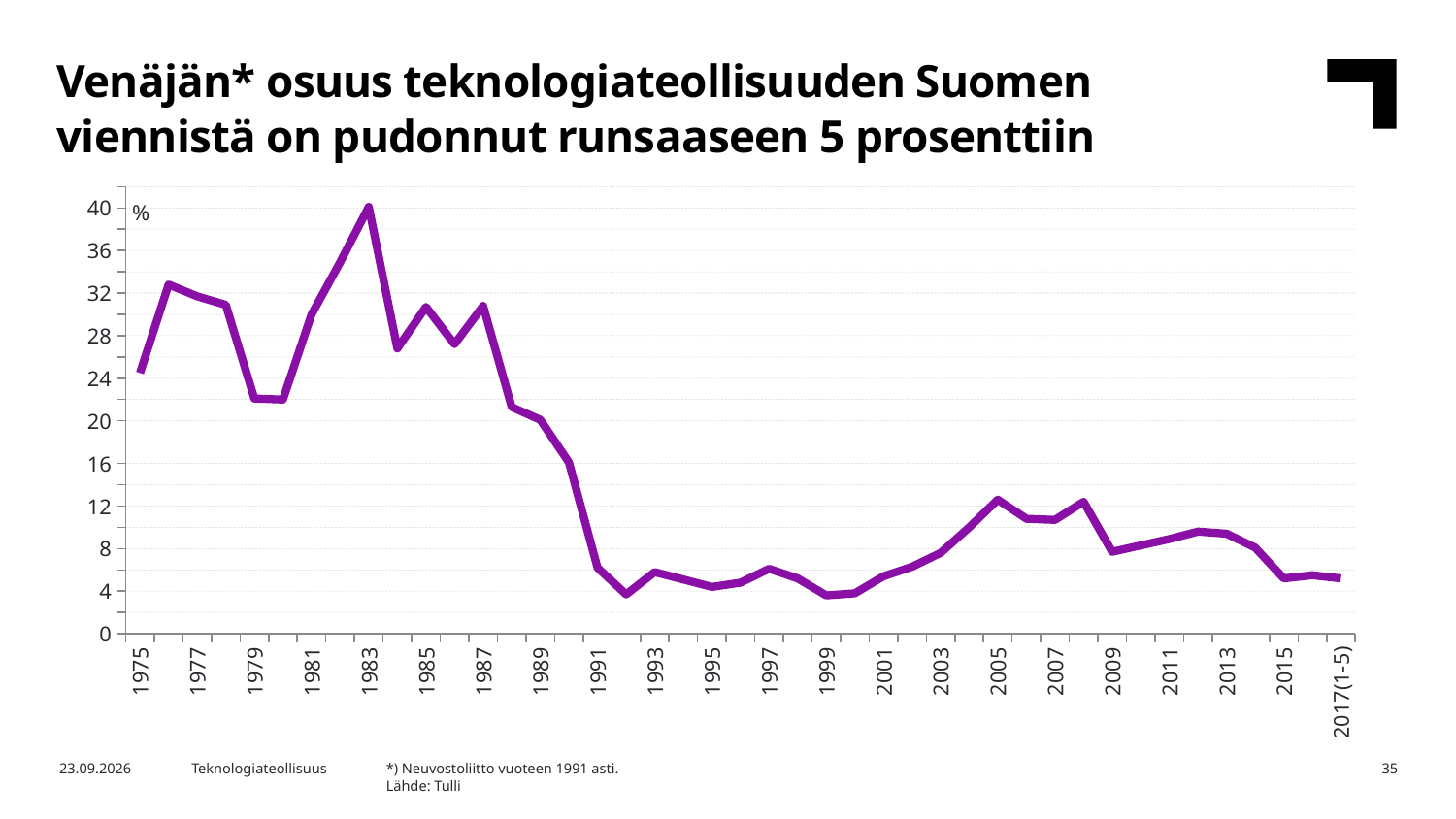
Is the value for 1991 greater or less than 8? less Is the value for 1975 greater or less than 20? greater Is the value for 2017(1-5) greater or less than 8? less What unit is shown at the top of the vertical axis? % Overall, does the line rise or fall from 1975 to 2017(1-5)? fall Which year has the larger value, 1977 or 1979? 1977 Which year has the larger value, 2005 or 2015? 2005 What kind of chart is shown on the slide? line chart In which year does the line reach its highest value? 1983